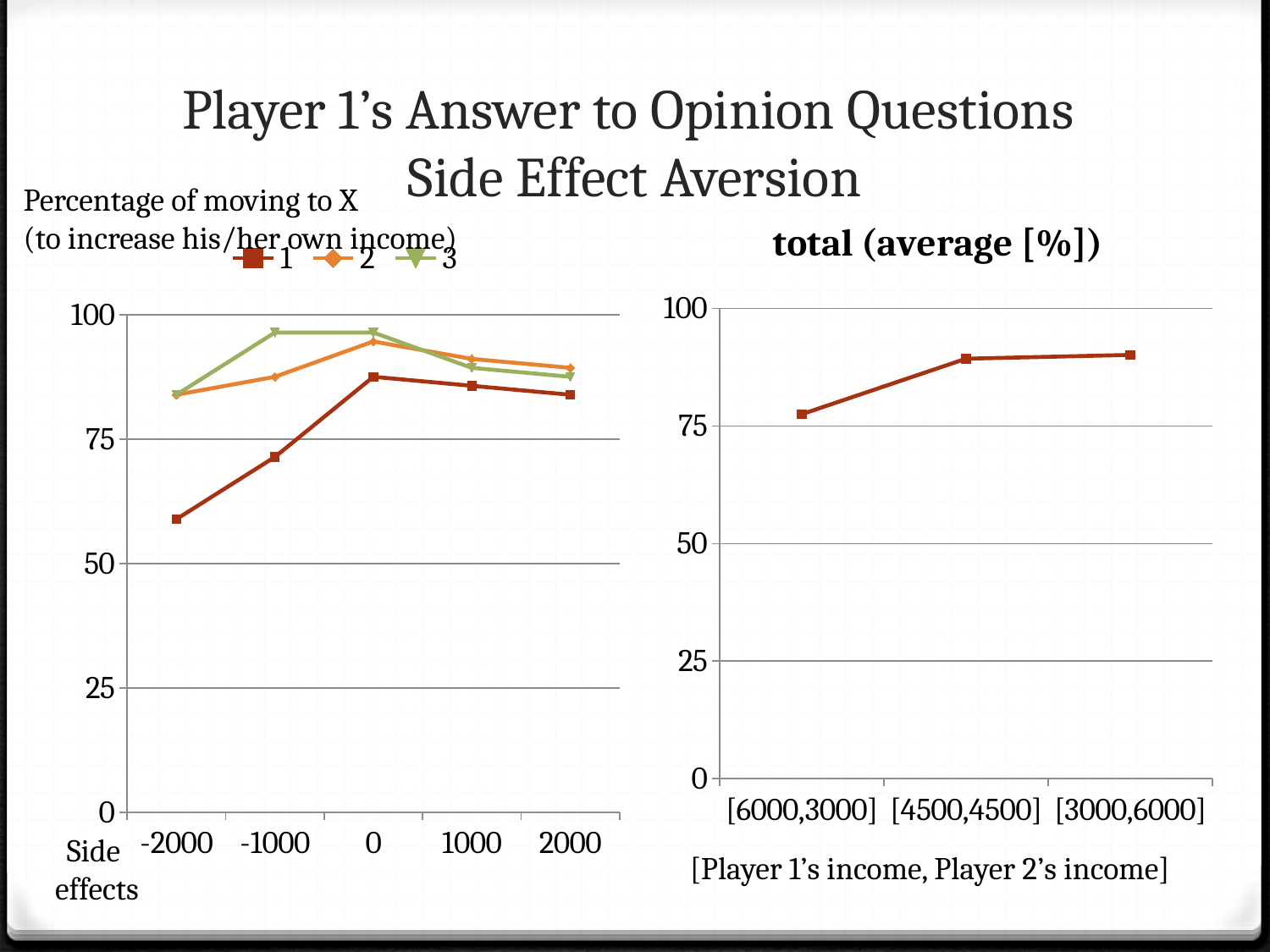
What kind of chart is the right chart titled 'total (average [%])'? line chart On the right chart titled 'total (average [%])', is the value for [4500,4500] greater or less than 75? greater On the left chart, how many series does the legend list? 3 On the left chart, is the value for series 1 at side effect -2000 greater or less than 50? greater On the right chart titled 'total (average [%])', do the values rise or fall from [6000,3000] to [3000,6000]? rise On the left chart, is the value for series 1 at side effect -2000 greater or less than 75? less On the left chart, how many side-effect values are shown on the x axis? 5 On the left chart, at side effect -2000, which series has the larger value, series 1 or series 3? series 3 On the right chart titled 'total (average [%])', how many categories are on the x axis? 3 On the left chart, at side effect -1000, which series has the larger value, series 1 or series 2? series 2 On the right chart titled 'total (average [%])', which category has the lowest value? [6000,3000]